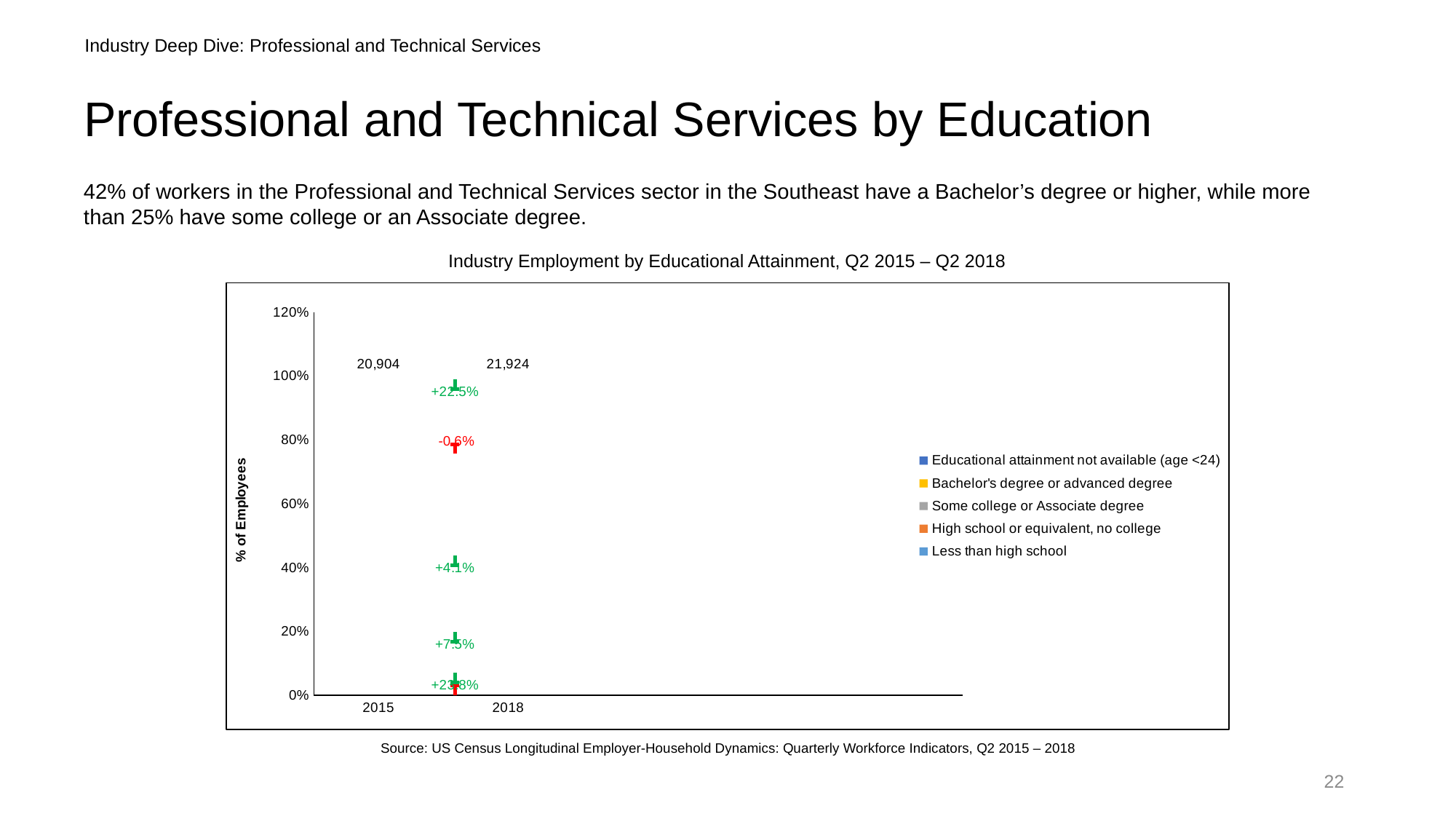
Which year has the larger total employment figure, 2015 or 2018? 2018 How many years are shown on the x axis of the chart? 2 What total employment figure is printed above the 2015 bar? 20,904 What is the title of the chart? Industry Employment by Educational Attainment, Q2 2015 – Q2 2018 What is the difference between the 2018 total (21,924) and the 2015 total (20,904)? 1,020 What percentage change label is printed just below the 100% gridline on the chart? +22.5% What total employment figure is printed above the 2018 bar? 21,924 How many series does the chart's legend list? 5 What is the label on the y axis of the chart? % of Employees What percentage change label is printed in red on the chart? -0.6%